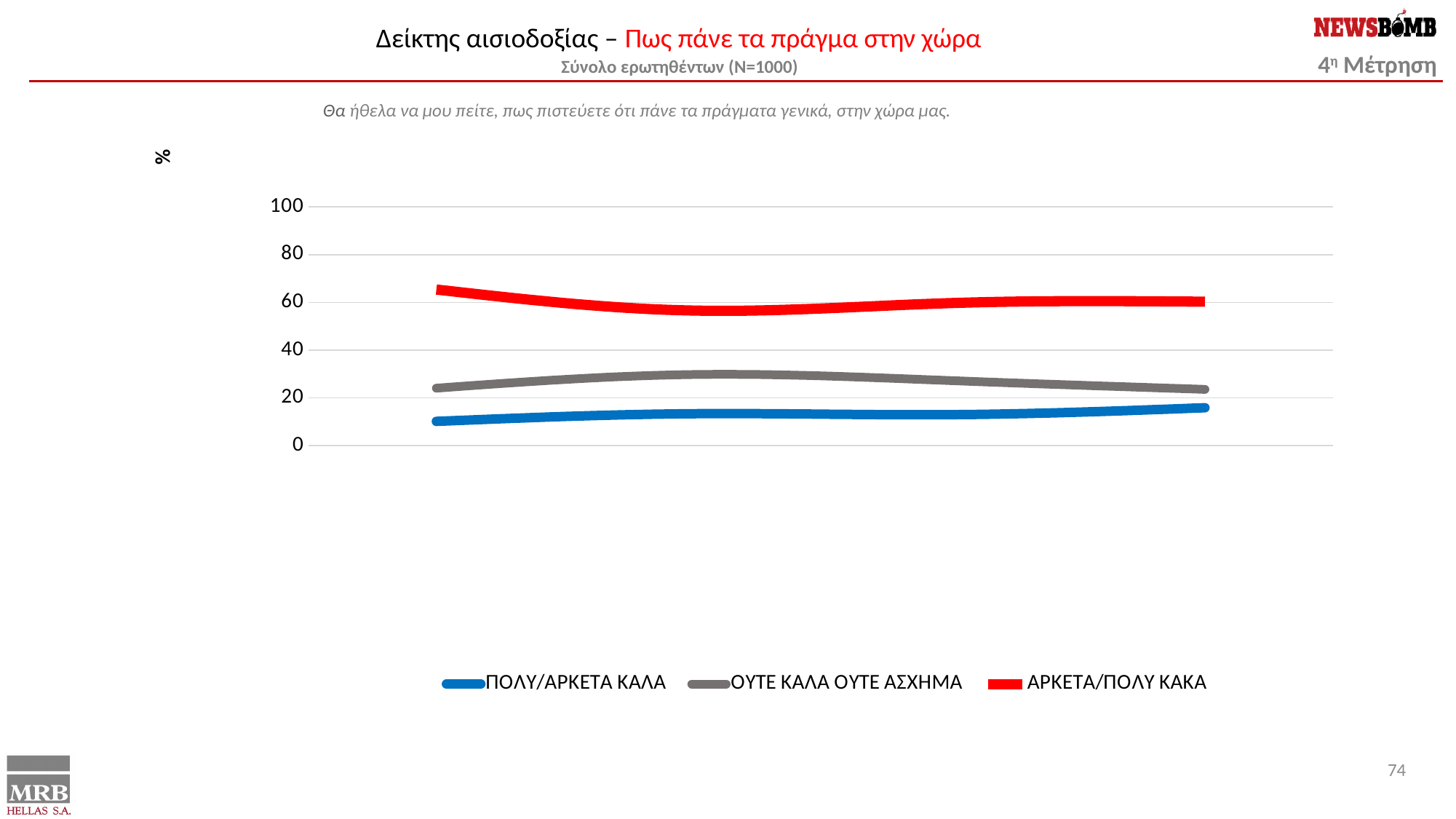
Which series has the highest values across the whole chart? ΑΡΚΕΤΑ/ΠΟΛΥ ΚΑΚΑ How many series does the legend list? 3 Is the value for ΑΡΚΕΤΑ/ΠΟΛΥ ΚΑΚΑ at the leftmost point greater or less than 60? greater What colour is the line for ΑΡΚΕΤΑ/ΠΟΛΥ ΚΑΚΑ? red Is the value for ΠΟΛΥ/ΑΡΚΕΤΑ ΚΑΛΑ at the leftmost point greater or less than 20? less At the rightmost point, which is higher: ΑΡΚΕΤΑ/ΠΟΛΥ ΚΑΚΑ or ΟΥΤΕ ΚΑΛΑ ΟΥΤΕ ΑΣΧΗΜΑ? ΑΡΚΕΤΑ/ΠΟΛΥ ΚΑΚΑ Does the ΠΟΛΥ/ΑΡΚΕΤΑ ΚΑΛΑ line rise or fall from its first point to its last point? rises What kind of chart is shown on the slide? line chart Is the value for ΑΡΚΕΤΑ/ΠΟΛΥ ΚΑΚΑ at the rightmost point greater or less than 40? greater Which series has the lowest values across the whole chart? ΠΟΛΥ/ΑΡΚΕΤΑ ΚΑΛΑ What are the three series named in the legend? ΠΟΛΥ/ΑΡΚΕΤΑ ΚΑΛΑ, ΟΥΤΕ ΚΑΛΑ ΟΥΤΕ ΑΣΧΗΜΑ, ΑΡΚΕΤΑ/ΠΟΛΥ ΚΑΚΑ